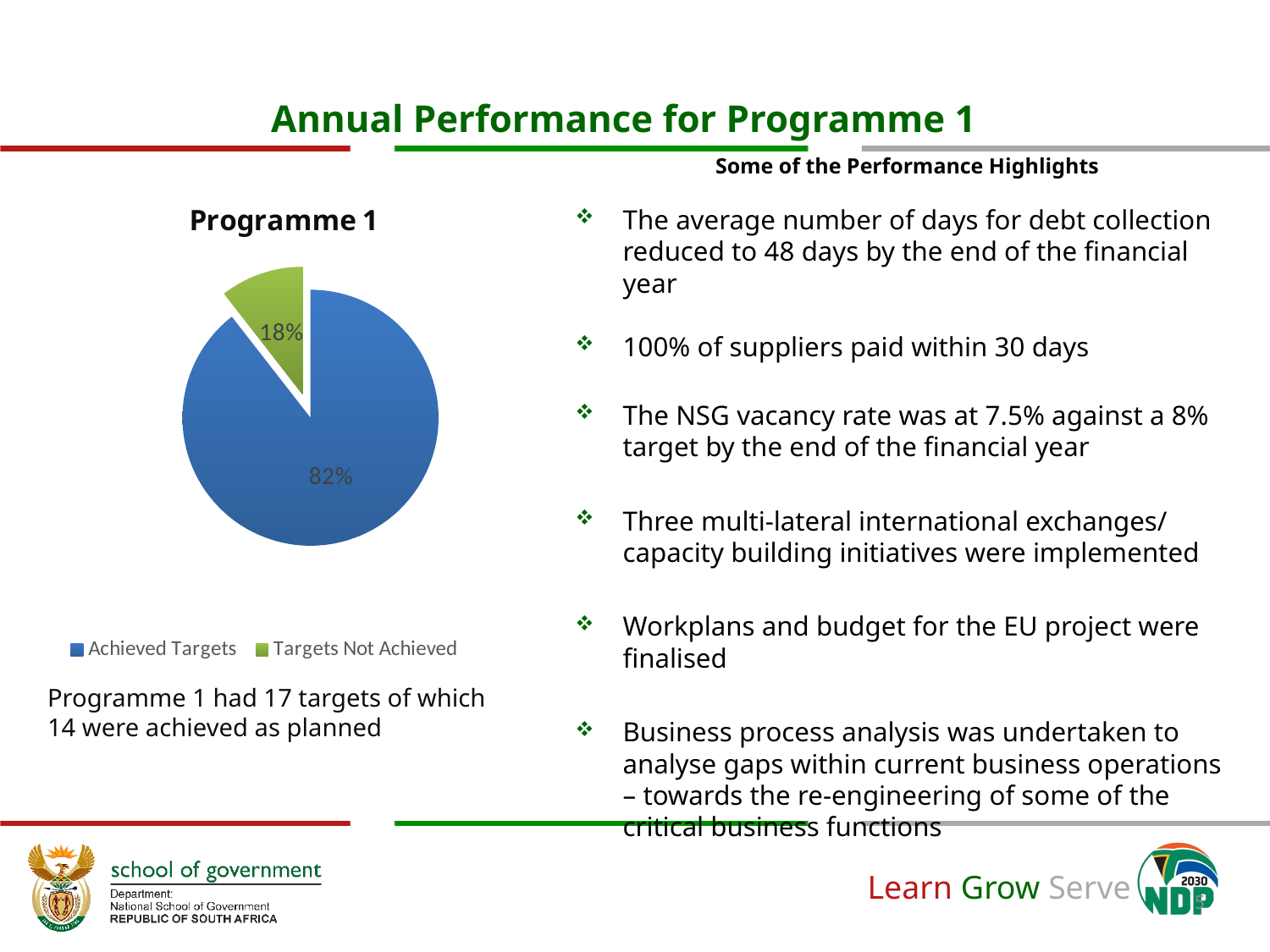
What percentage of the pie is Achieved Targets? 82% What share of the pie does Achieved Targets represent? 82% What colour is the Targets Not Achieved slice? green Which is larger, Achieved Targets or Targets Not Achieved? Achieved Targets Which slice is the smallest? Targets Not Achieved Which slice is the largest? Achieved Targets What is the chart's title? Programme 1 How many entries does the legend list? 2 What type of chart is shown on the slide? pie chart How many slices does the pie chart have? 2 What is the difference in percentage points between Achieved Targets and Targets Not Achieved? 64 What percentage of the pie is Targets Not Achieved? 18%